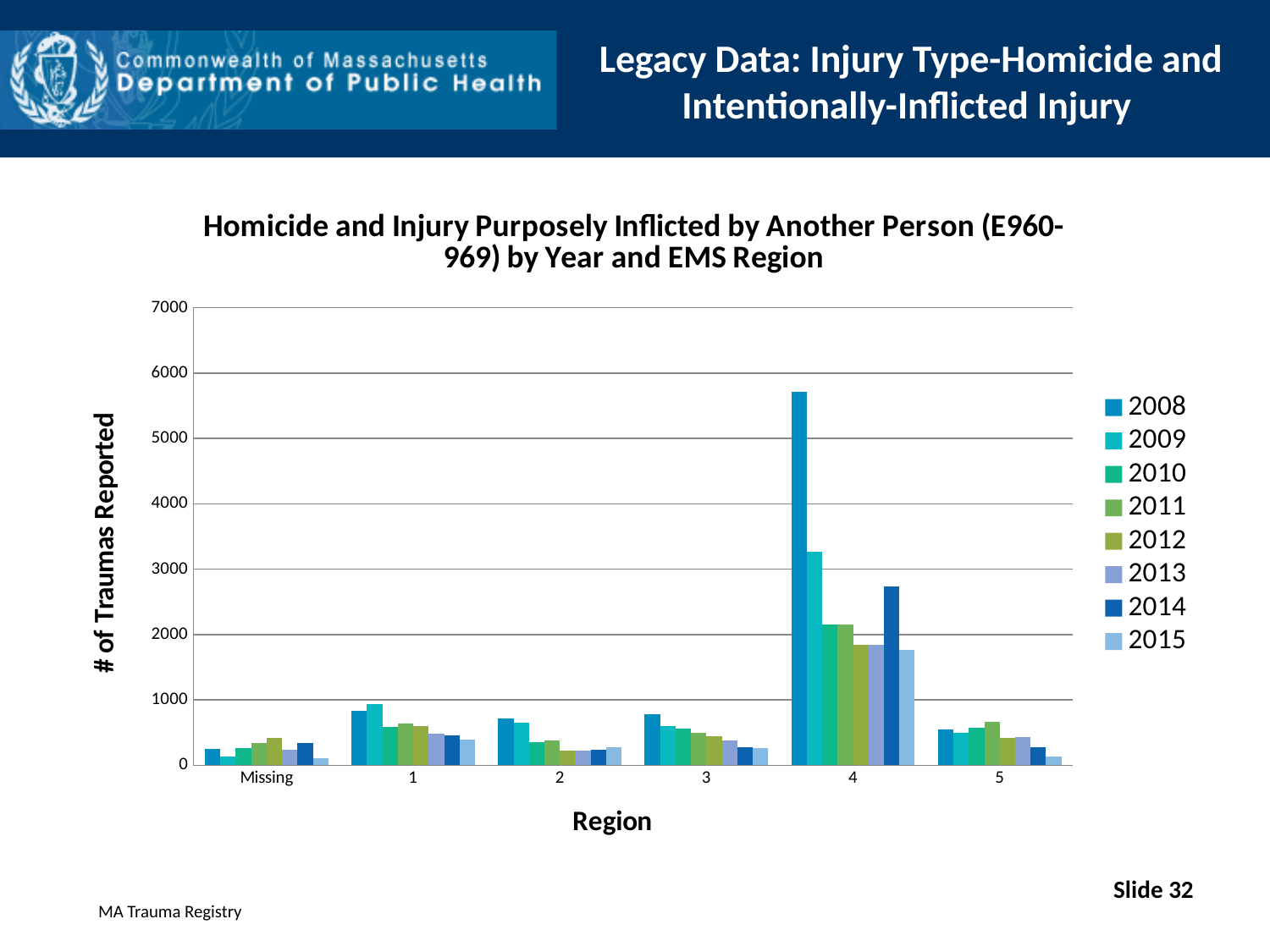
Is the 2009 value for Region 1 greater or less than 1000? less What is the title of the x axis? Region Do the values for Region 3 generally rise or fall from 2008 to 2015? fall What kind of chart is shown on the slide? bar chart What is the title of the y axis? # of Traumas Reported Which region has the highest value for 2008? 4 How many series does the legend list? 8 Is the 2014 value for Region 4 greater or less than 2000? greater Is the 2008 value for Region 4 greater or less than 5000? greater How many region categories are shown on the x axis? 6 In Region 4, which is larger, the 2014 value or the 2015 value? 2014